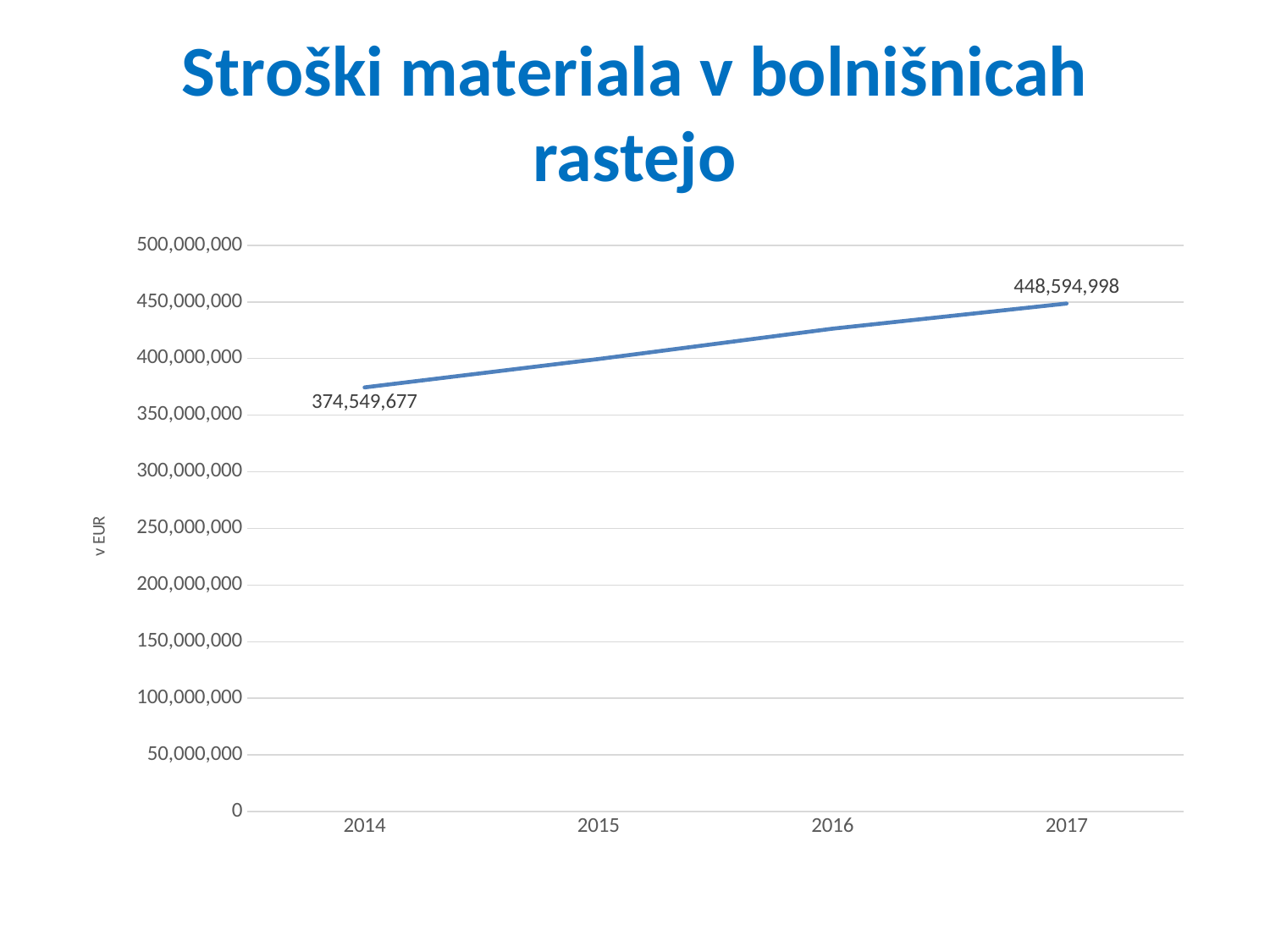
Is the value for 2016 greater or less than 400,000,000? greater Which is larger, the value for 2014 or the value for 2017? 2017 What is the label on the vertical axis? v EUR What is the value for 2014? 374,549,677 What kind of chart is shown on the slide? line chart What is the value for 2017? 448,594,998 How many years are shown on the x axis? 4 Do the values rise or fall from 2014 to 2017? rise Which year has the highest value? 2017 Is the value for 2015 greater or less than 350,000,000? greater Which year has the lowest value? 2014 What is the difference between the 2017 value and the 2014 value? 74,045,321